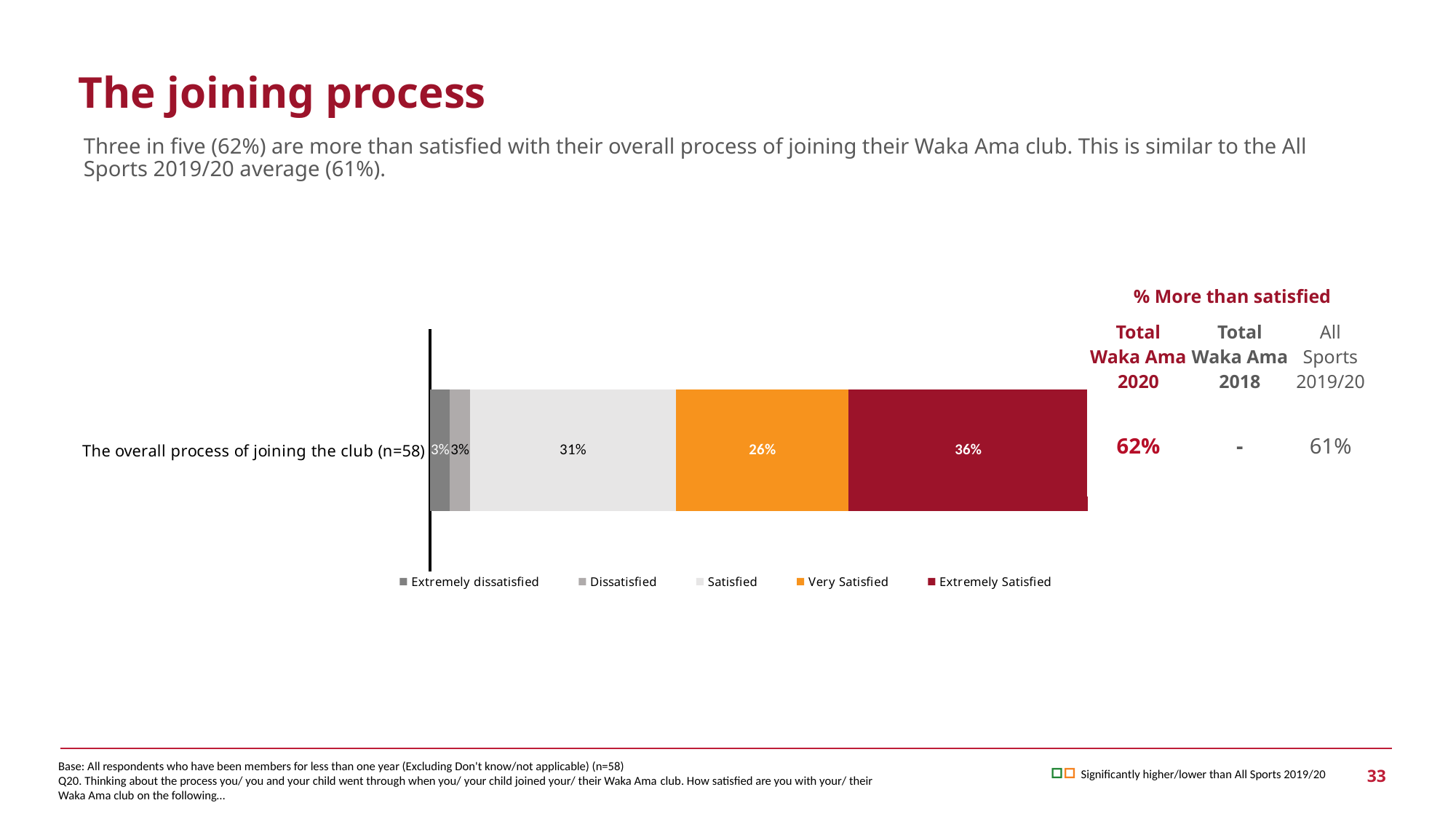
What is the sample size (n) shown for the overall process of joining the club? 58 What is the '% More than satisfied' value for All Sports 2019/20? 61% What is the difference between the Extremely Satisfied and Very Satisfied percentages for the overall process of joining the club? 10% Which is larger for the overall process of joining the club: the Satisfied share or the Very Satisfied share? Satisfied Which satisfaction level has the largest share of the bar for the overall process of joining the club? Extremely Satisfied What percentage of respondents are Very Satisfied with the overall process of joining the club? 26% What kind of chart is shown on the slide? Stacked bar chart How many series does the legend list? 5 What is the combined percentage of Very Satisfied and Extremely Satisfied for the overall process of joining the club? 62% What percentage of respondents are Extremely Satisfied with the overall process of joining the club? 36% What percentage of respondents are Satisfied with the overall process of joining the club? 31% What percentage of respondents are Dissatisfied with the overall process of joining the club? 3%